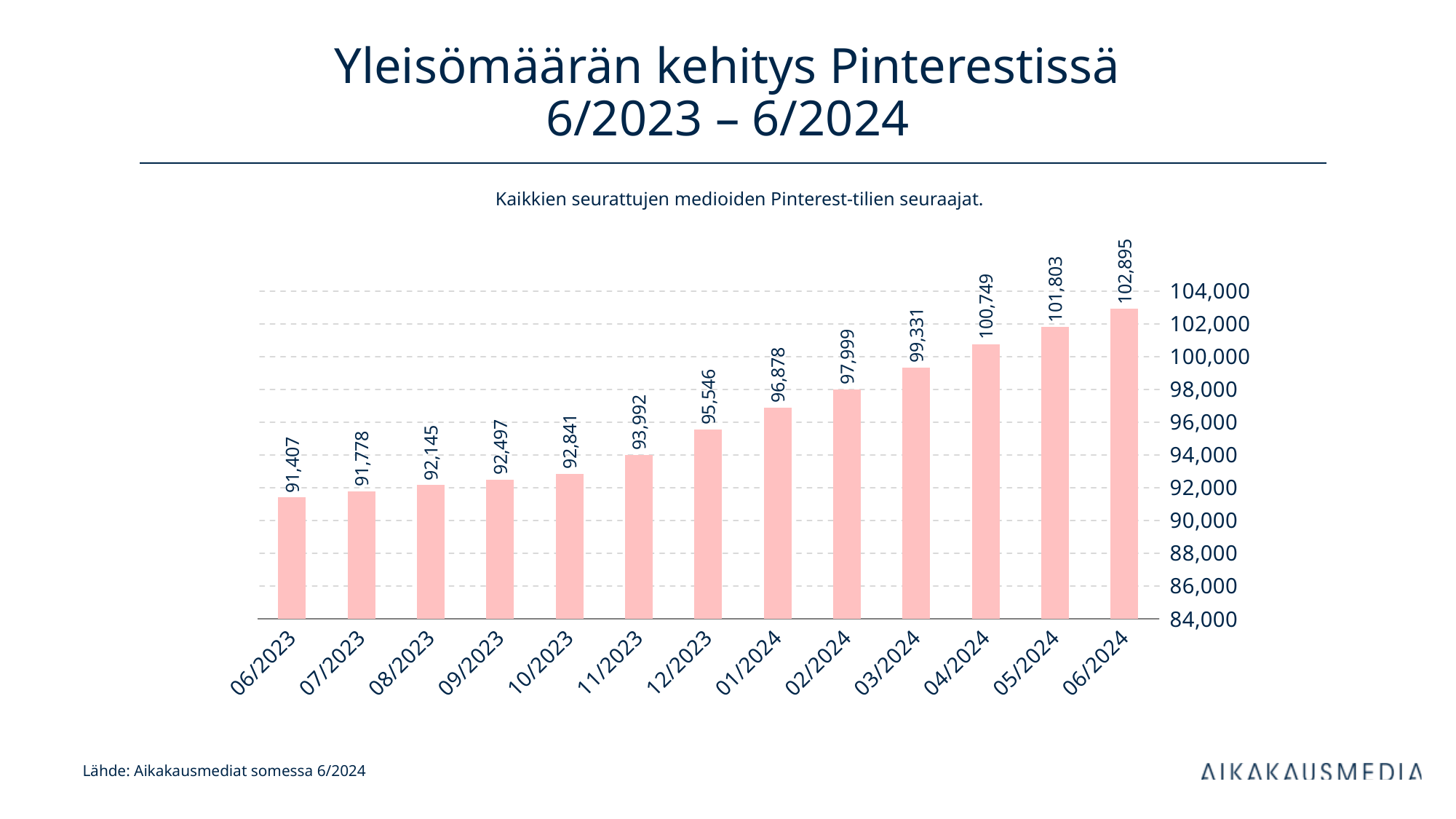
Do the values rise or fall from 06/2023 to 06/2024? rise What is the value for 01/2024? 96,878 What is the value for 06/2024? 102,895 What is the difference between the values for 05/2024 and 04/2024? 1,054 Is the value for 03/2024 greater or less than 100,000? less What is the difference between the values for 06/2024 and 06/2023? 11,488 Which month has the highest value? 06/2024 What kind of chart is shown on the slide? bar chart Which is larger, the value for 12/2023 or the value for 02/2024? 02/2024 What is the value for 06/2023? 91,407 How many months are shown on the x axis? 13 Which month has the lowest value? 06/2023